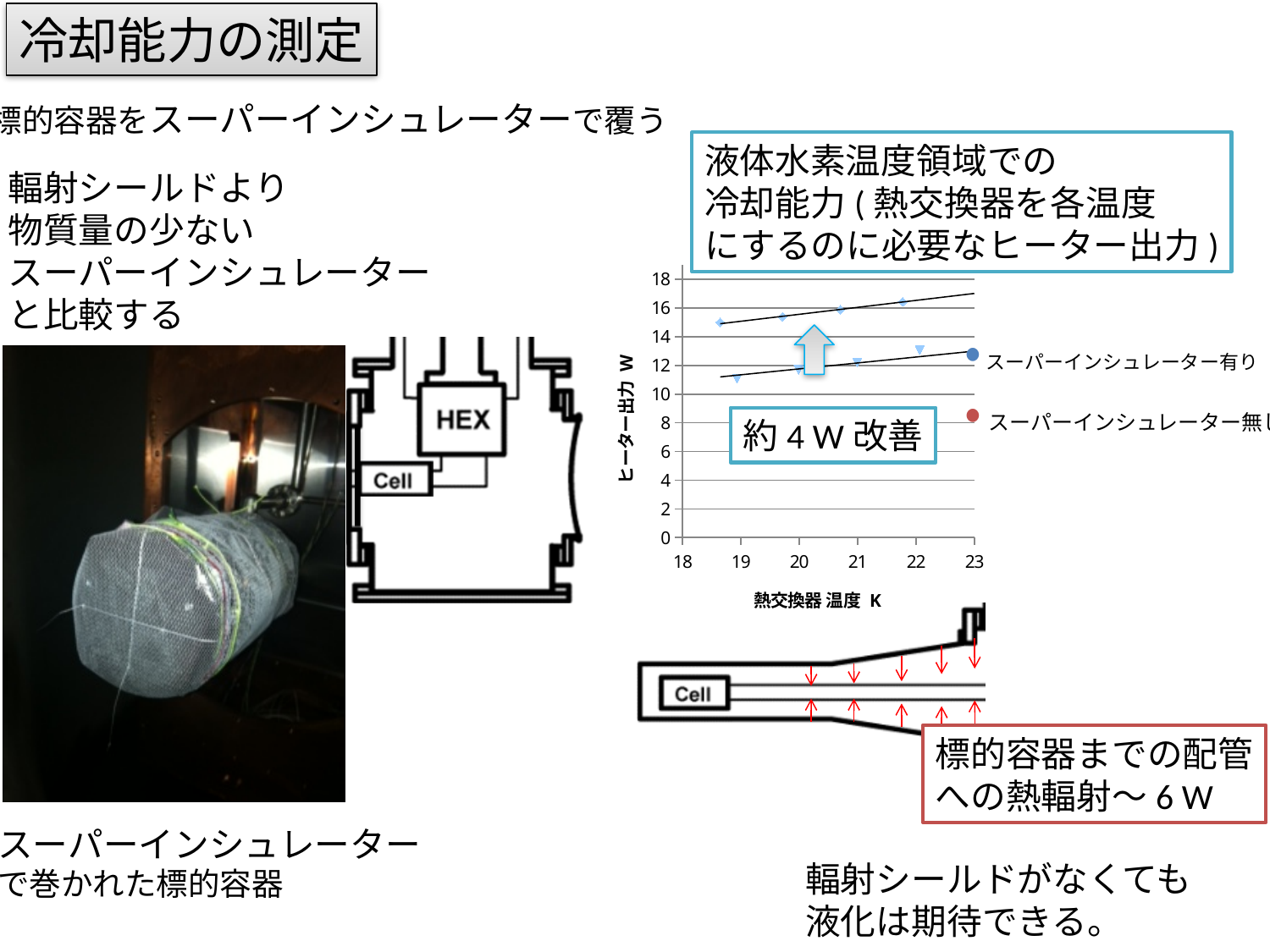
Is the heater output of the upper series at about 21 K greater or less than 18 W? less What is the title of the chart's horizontal axis? 熱交換器 温度 K What is the title of the chart's vertical axis? ヒーター出力 W What is the highest value shown on the chart's vertical axis? 18 Is the heater output of the lower series at about 19 K greater or less than 12 W? less Do the plotted heater output values rise or fall as the heat exchanger temperature increases? rise Is the heater output of the upper series at about 22 K greater or less than 14 W? greater What kind of chart is shown on the slide? scatter chart How many series does the chart's legend list? 2